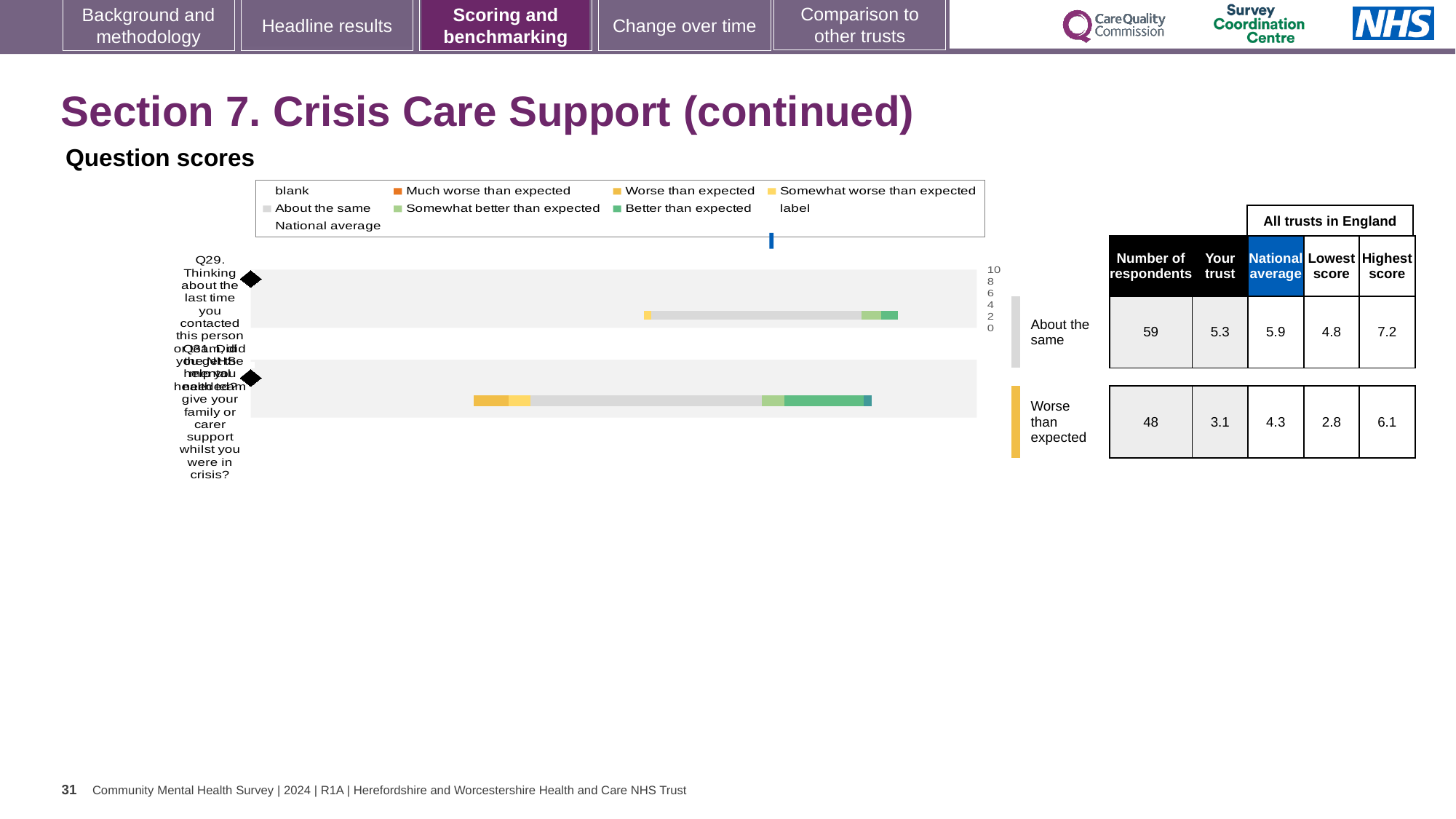
What benchmark category is shown for Q31 to the right of the chart? Worse than expected What is the 'Your trust' score for Q29 in the table next to the chart? 5.3 How many respondents answered Q29? 59 By how much does the national average for Q29 exceed the trust's score for Q29? 0.6 What is the lowest score among all trusts in England for Q31? 2.8 What is the national average score for Q31? 4.3 What is the highest score among all trusts in England for Q31? 6.1 What kind of chart is used to show the question scores on this slide? bar chart Which question has the higher 'Your trust' score, Q29 or Q31? Q29 What is the difference between the highest and lowest scores for Q29? 2.4 How many questions are plotted in the question scores chart? 2 What benchmark category is shown for Q29 to the right of the chart? About the same